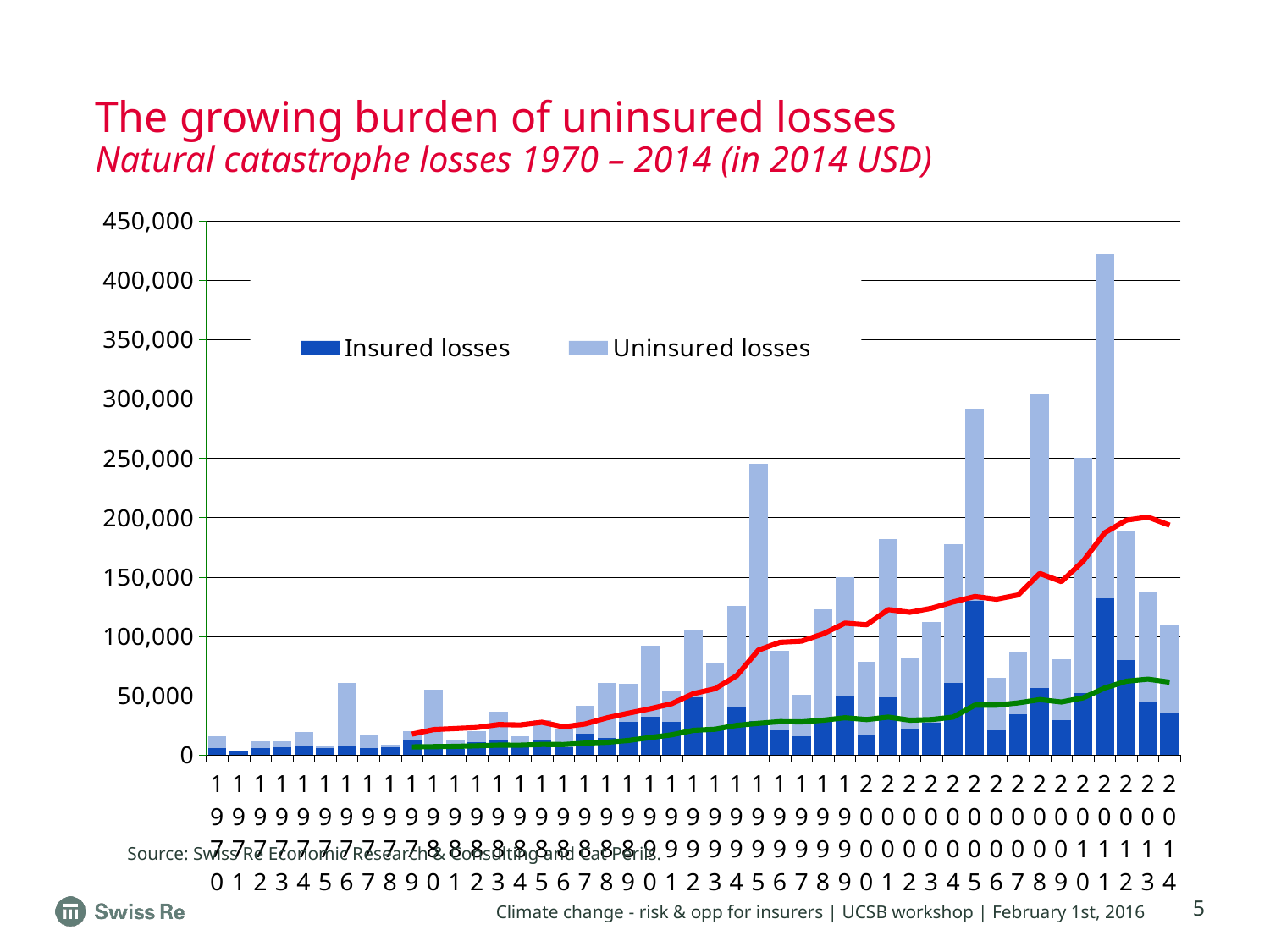
Which year has the highest total natural catastrophe losses? 2011 How many years (bars) are plotted on the x axis? 45 Which year has larger total losses, 2011 or 2008? 2011 Is the total loss for 2004 greater or less than 200,000? less Is the total loss for 1970 greater or less than 50,000? less What are the two series named in the legend? Insured losses and Uninsured losses Is the total loss for 2011 greater or less than 400,000? greater What is the title of the chart slide? The growing burden of uninsured losses What kind of chart is shown on the slide? Combination stacked bar and line chart How many series does the legend list? 2 Do total natural catastrophe losses generally rise or fall from 1970 to 2014? rise